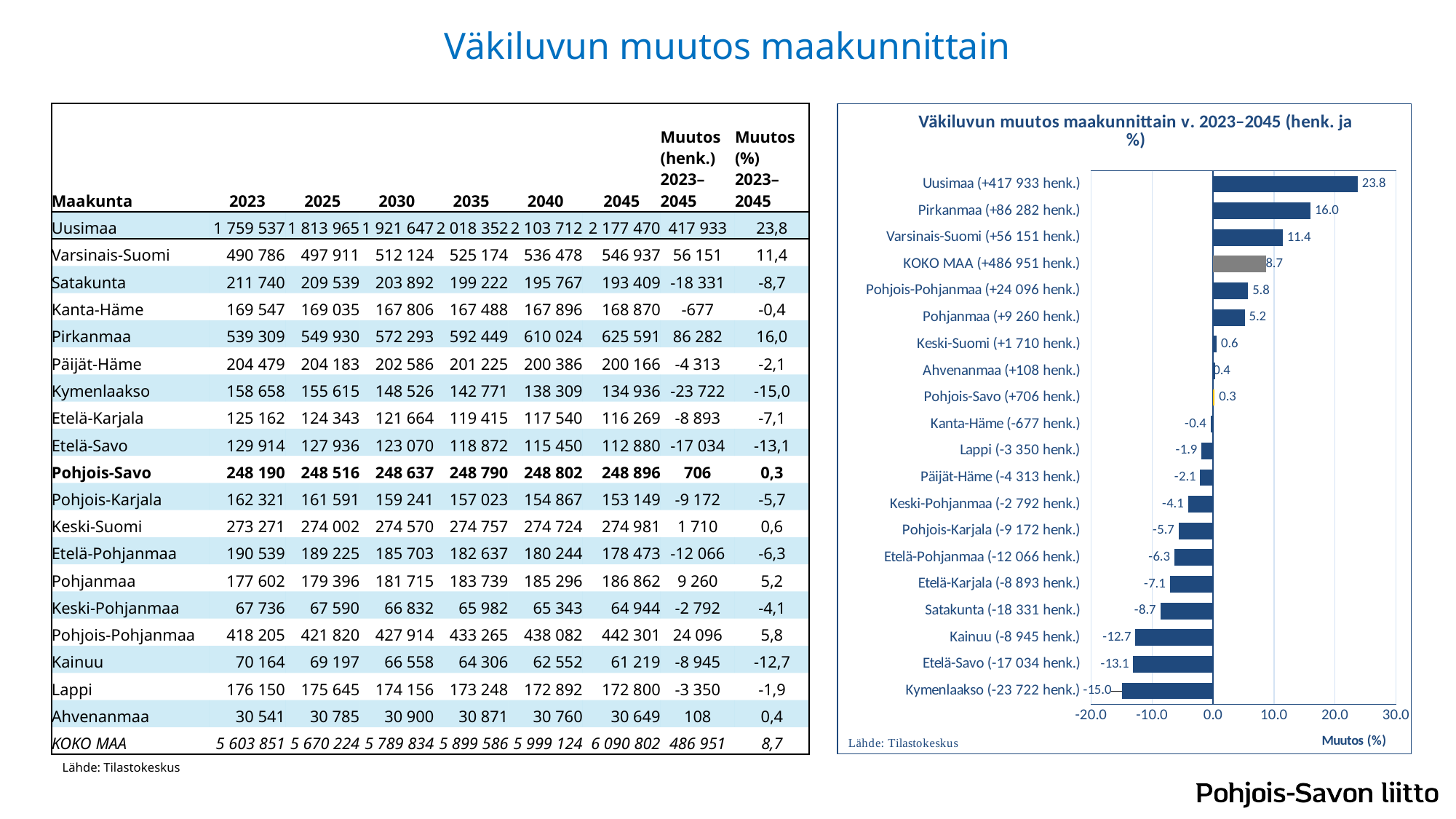
How many bars are plotted in the chart? 20 What type of chart is shown on the right side of the slide? bar chart In the chart, what is the label of the horizontal axis? Muutos (%) In the chart, what is the percentage change shown for Kymenlaakso? -15.0 In the chart, which region has the highest percentage change? Uusimaa In the chart, what is the percentage change shown for KOKO MAA? 8.7 In the chart, what is the difference between the percentage change for Uusimaa and for Pirkanmaa? 7.8 In the chart, which bar is coloured grey instead of blue? KOKO MAA In the chart, what is the percentage change shown for Uusimaa? 23.8 In the chart, which region has the lowest percentage change? Kymenlaakso In the chart, which has a larger percentage change, Pohjois-Pohjanmaa or Pohjanmaa? Pohjois-Pohjanmaa In the chart, is the value for Uusimaa greater or less than 20.0? greater